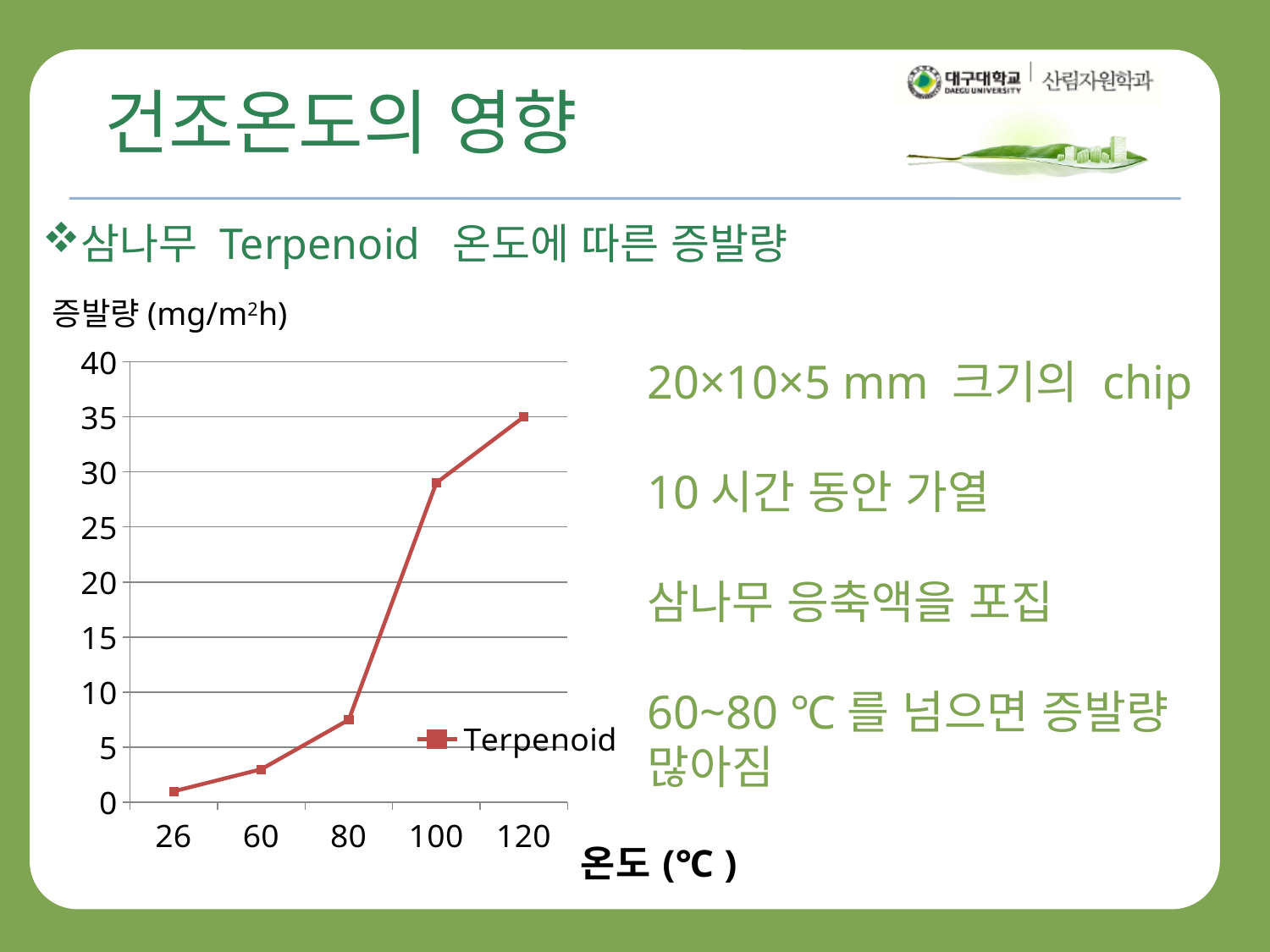
How many temperature points are plotted on the x axis of the chart? 5 What is the name of the series shown in the chart's legend? Terpenoid Do the Terpenoid values rise or fall as temperature increases along the x axis? rise Is the Terpenoid value at 100 °C greater or less than 25? greater What is the title of the chart's x axis? 온도 (℃ ) Is the Terpenoid value at 80 °C greater or less than 10? less How many series does the chart's legend list? 1 Which temperature has the larger Terpenoid value, 80 °C or 100 °C? 100 Is the Terpenoid value at 60 °C greater or less than 5? less What kind of chart is shown on the slide? line chart At which temperature is the Terpenoid evaporation value highest? 120 At which temperature is the Terpenoid evaporation value lowest? 26